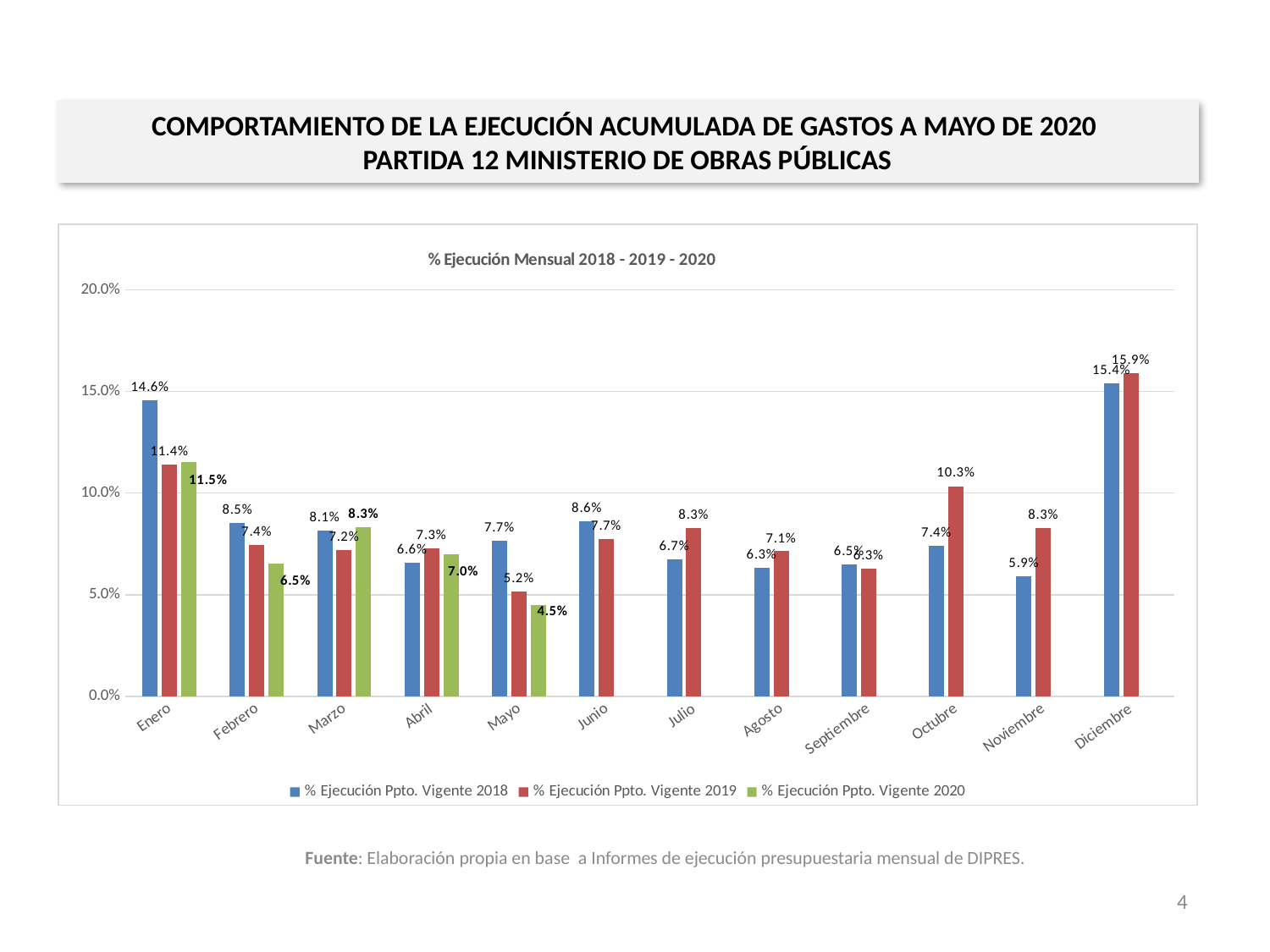
Which is larger for Marzo: the 2018 value or the 2020 value? 2020 value (8.3%) What is the value for Mayo in the % Ejecución Ppto. Vigente 2020 series? 4.5% Is the 2019 value for Diciembre greater or less than 15.0%? greater How many series does the legend list? 3 What is the difference between the 2018 and 2019 values for Enero? 3.2% What kind of chart is shown on the slide? Bar chart What is the title of the chart? % Ejecución Mensual 2018 - 2019 - 2020 Which month has the highest value in the % Ejecución Ppto. Vigente 2019 series? Diciembre Which month has the lowest value in the % Ejecución Ppto. Vigente 2018 series? Noviembre What is the value for Enero in the % Ejecución Ppto. Vigente 2018 series? 14.6% How many months are shown on the x axis? 12 What is the value for Octubre in the % Ejecución Ppto. Vigente 2019 series? 10.3%